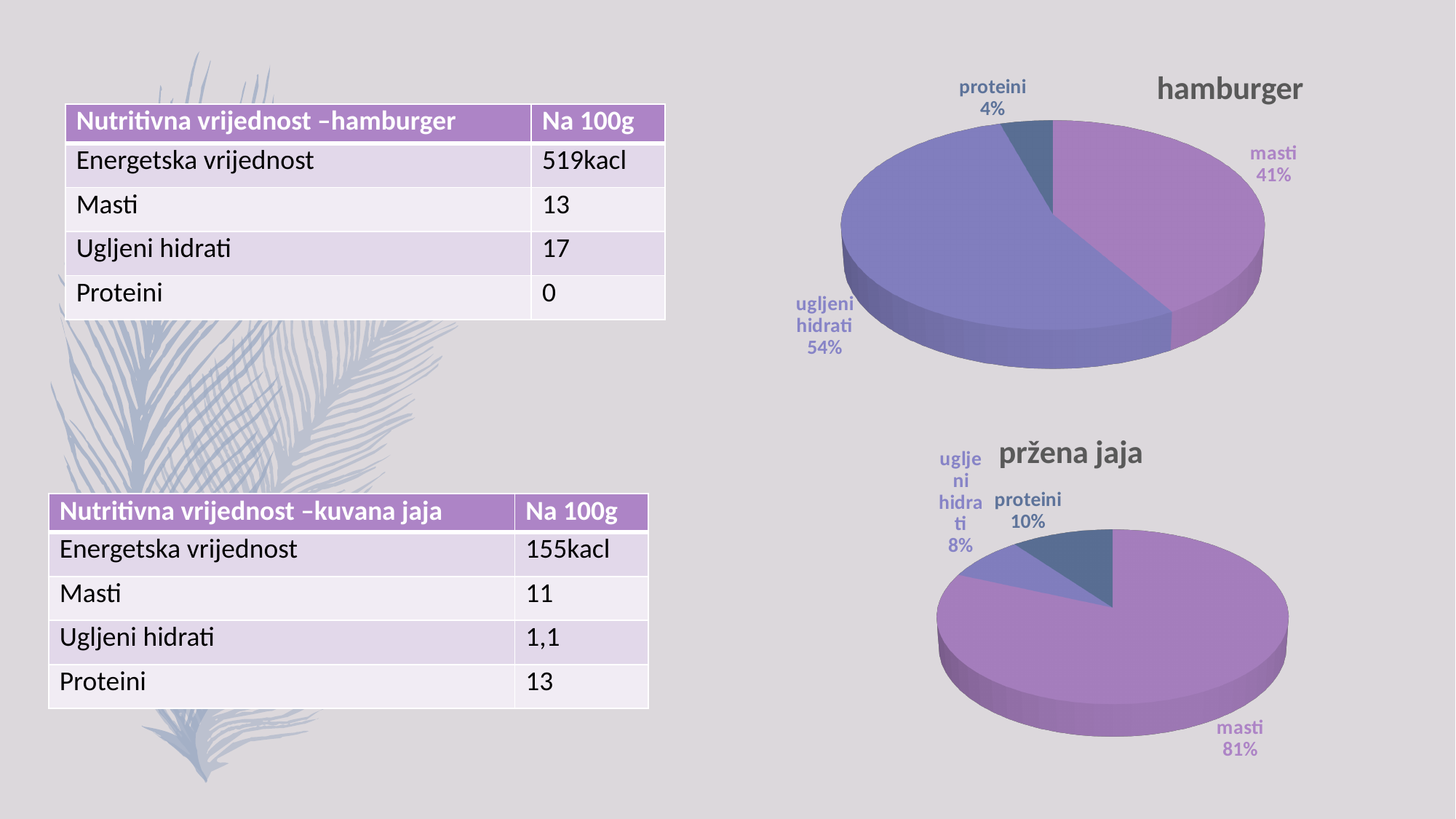
In the "hamburger" chart, which slice is the largest? ugljeni hidrati In the "hamburger" chart, what share does masti have? 41% How many slices does the "pržena jaja" chart have? 3 In the "pržena jaja" chart, which is larger, proteini or ugljeni hidrati? proteini In the "pržena jaja" chart, which slice is the largest? masti In the "pržena jaja" chart, what share does masti have? 81% In the "pržena jaja" chart, what share does proteini have? 10% In the "hamburger" chart, what is the difference in percentage points between ugljeni hidrati and masti? 13 What type of chart is the "hamburger" chart? pie chart In the "hamburger" chart, which slice is the smallest? proteini